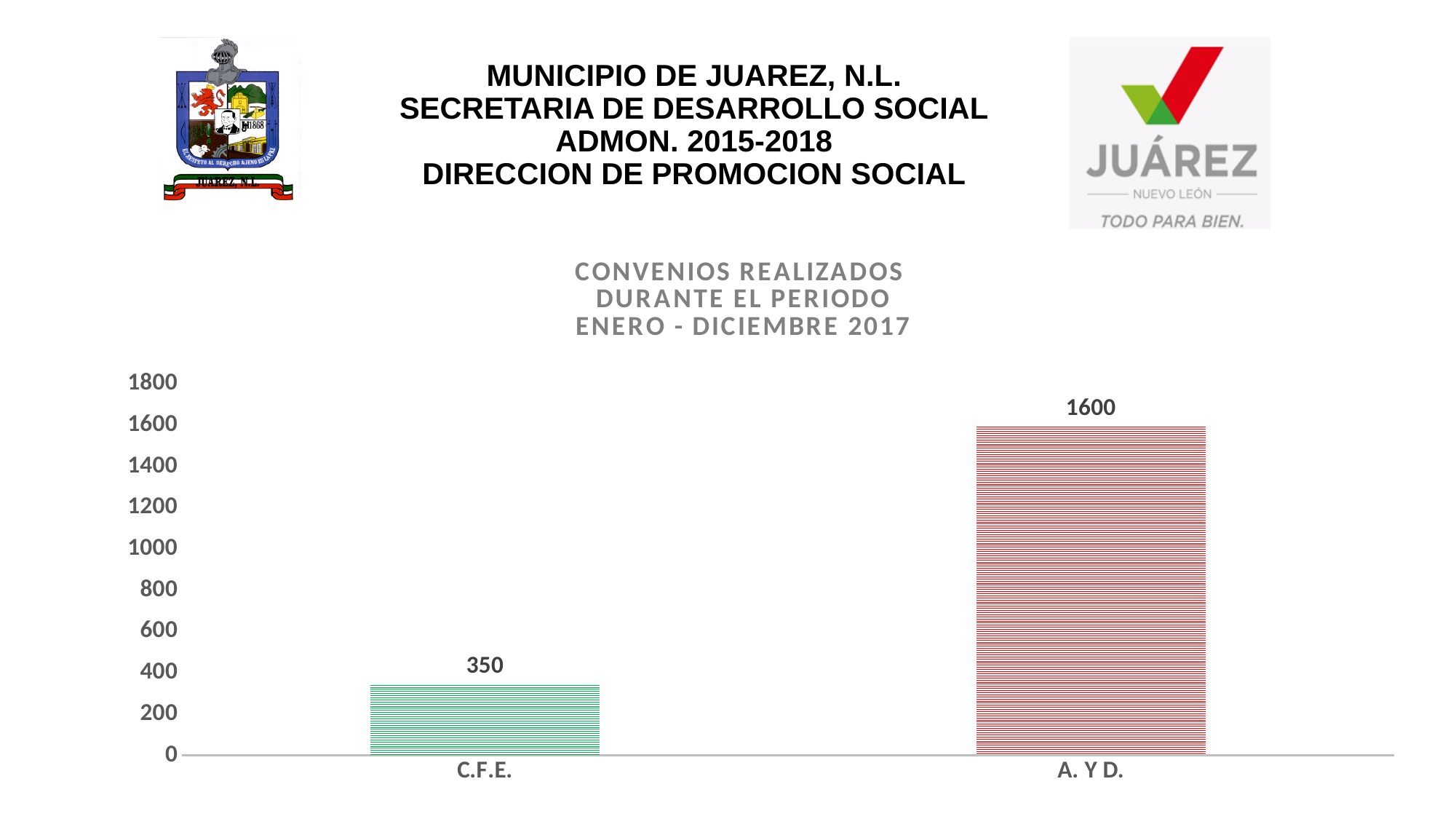
What kind of chart is shown on the slide? bar chart What is the difference between the values for A. Y D. and C.F.E.? 1250 How many categories are shown on the chart? 2 What is the title of the chart? CONVENIOS REALIZADOS DURANTE EL PERIODO ENERO - DICIEMBRE 2017 Which category has the highest value? A. Y D. Is the value for C.F.E. greater or less than 400? less Which is larger, the value for C.F.E. or the value for A. Y D.? A. Y D. What is the value for C.F.E.? 350 What is the value for A. Y D.? 1600 Which category has the lowest value? C.F.E. What colour is the bar for A. Y D.? red Is the value for A. Y D. greater or less than 1400? greater